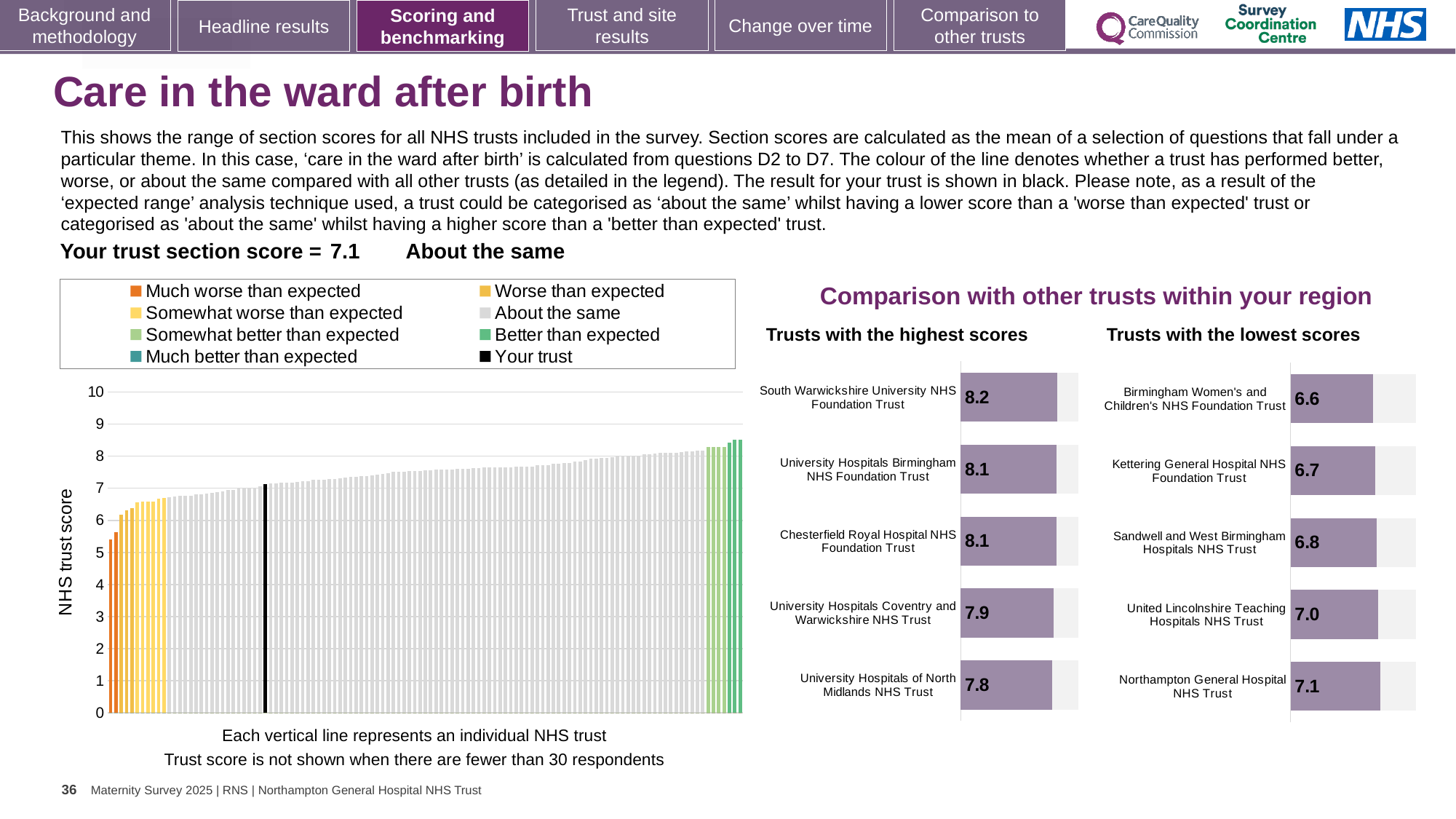
What kind of chart is the large chart on the left showing NHS trust scores? Bar chart In the 'Trusts with the lowest scores' chart, what is the score for Northampton General Hospital NHS Trust? 7.1 In the 'Trusts with the highest scores' chart, which trust has the highest score? South Warwickshire University NHS Foundation Trust In the 'Trusts with the highest scores' chart, what is the difference between the scores of South Warwickshire University NHS Foundation Trust and University Hospitals of North Midlands NHS Trust? 0.4 In the 'Trusts with the lowest scores' chart, which trust has the lowest score? Birmingham Women's and Children's NHS Foundation Trust How many trusts are shown in the 'Trusts with the highest scores' chart? 5 In the 'Trusts with the lowest scores' chart, what is the score for Kettering General Hospital NHS Foundation Trust? 6.7 In the 'Trusts with the lowest scores' chart, which has the larger score: Sandwell and West Birmingham Hospitals NHS Trust or United Lincolnshire Teaching Hospitals NHS Trust? United Lincolnshire Teaching Hospitals NHS Trust How many entries does the legend above the left-hand chart list? 8 What is the y-axis label of the large chart on the left? NHS trust score In the 'Trusts with the highest scores' chart, what is the score for South Warwickshire University NHS Foundation Trust? 8.2 In the 'Trusts with the lowest scores' chart, how much higher is Northampton General Hospital NHS Trust's score than Birmingham Women's and Children's NHS Foundation Trust's score? 0.5